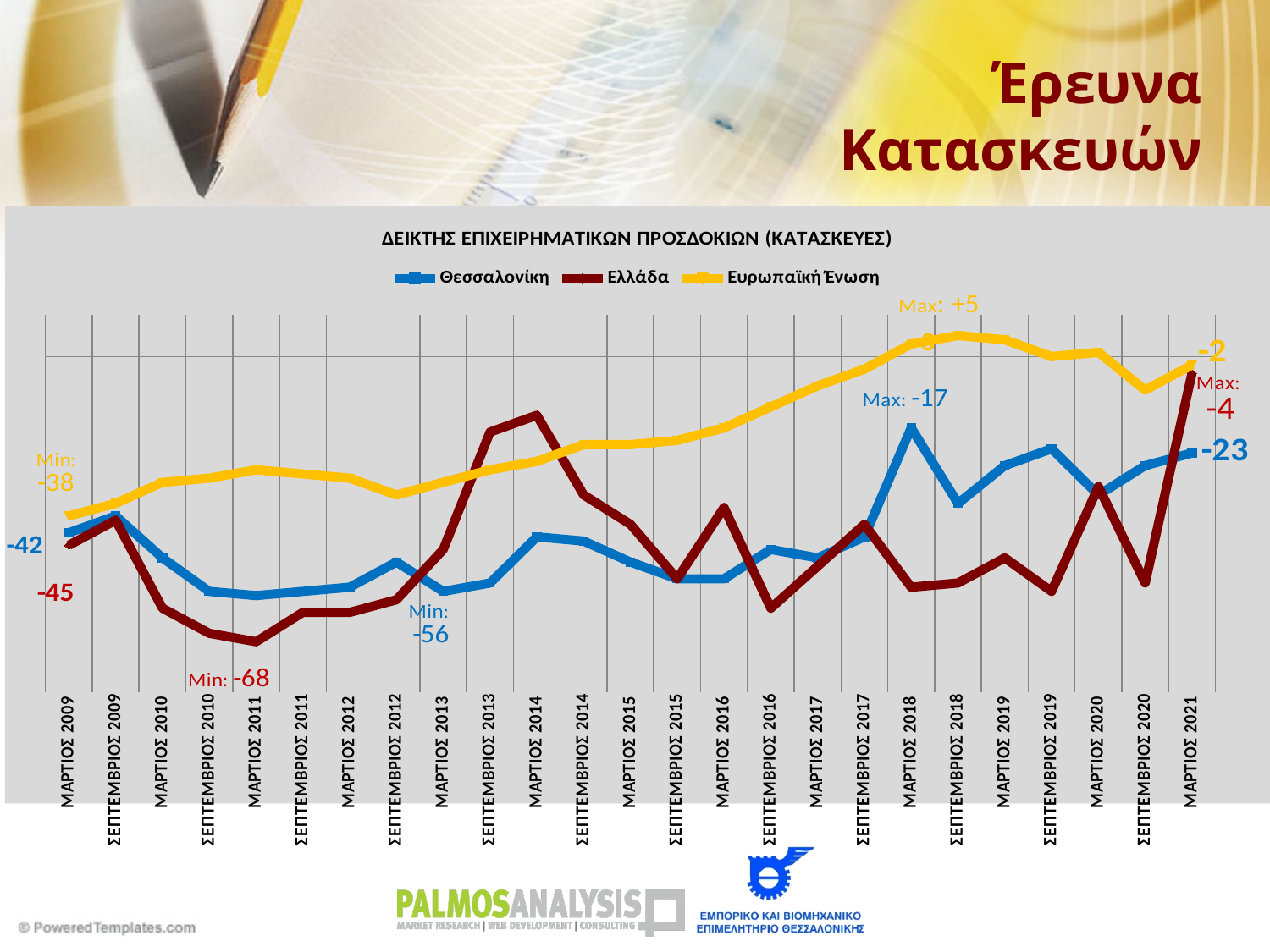
What is the difference between the Ελλάδα and Θεσσαλονίκη values in ΜΑΡΤΙΟΣ 2021? 19 What is the value for Θεσσαλονίκη in ΜΑΡΤΙΟΣ 2009? -42 What is the value for Ευρωπαϊκή Ένωση in ΜΑΡΤΙΟΣ 2021? -2 How many time points are shown on the x axis? 25 What is the minimum value reached by the Ελλάδα series? -68 What kind of chart is shown on the slide? line chart What is the maximum value reached by the Ευρωπαϊκή Ένωση series? +5 How many series does the legend list? 3 What is the value for Ελλάδα in ΜΑΡΤΙΟΣ 2021? -4 In ΜΑΡΤΙΟΣ 2021, which is higher: Ελλάδα or Θεσσαλονίκη? Ελλάδα What is the maximum value reached by the Θεσσαλονίκη series? -17 What is the value for Θεσσαλονίκη in ΜΑΡΤΙΟΣ 2021? -23